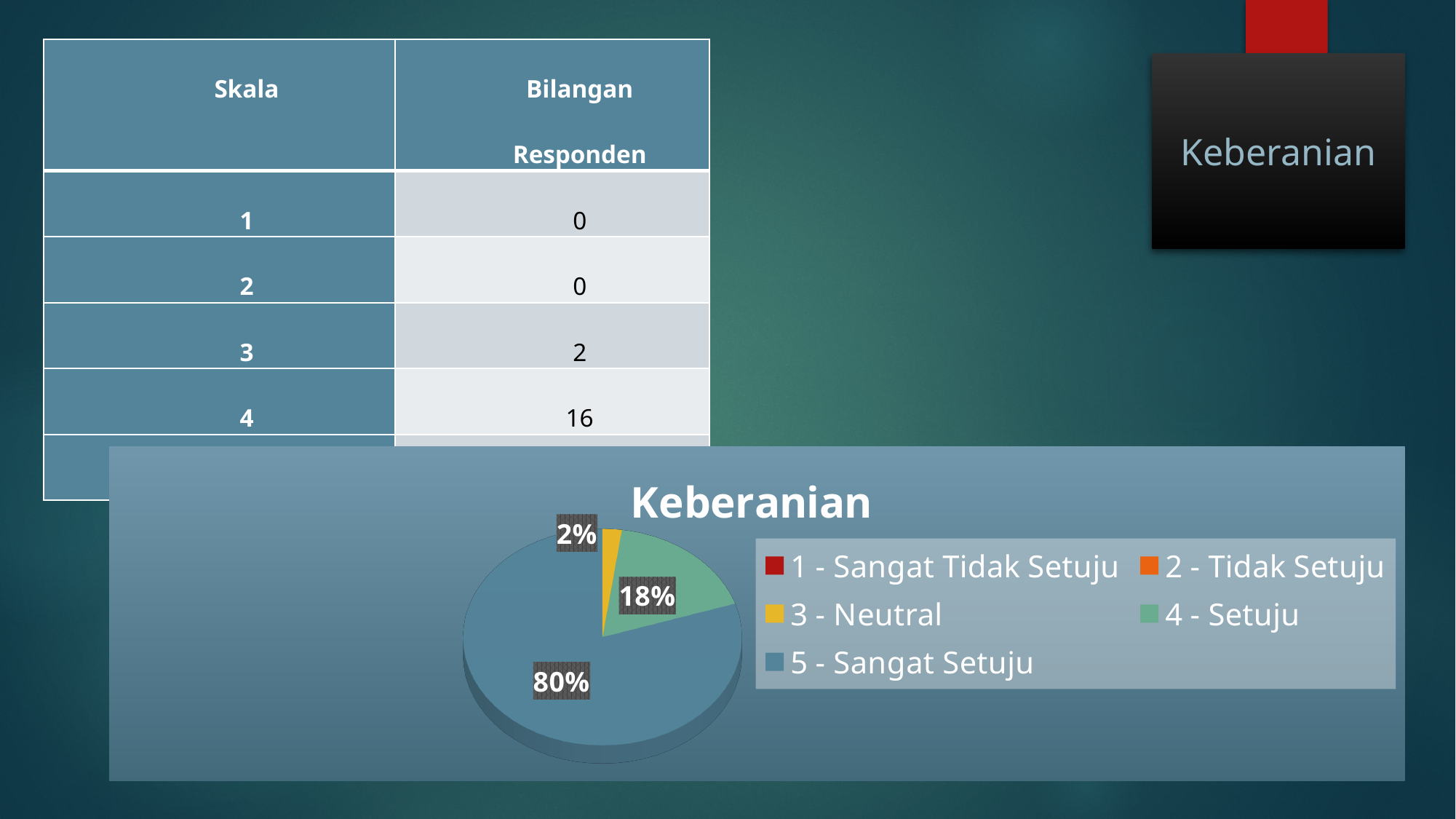
What share of the pie does the "4 - Setuju" slice represent? 18% What share of the pie does the "3 - Neutral" slice represent? 2% What share of the pie does the "5 - Sangat Setuju" slice represent? 80% What colour is the "4 - Setuju" slice in the pie chart? Green What kind of chart is shown on the slide? Pie chart Which of the visible slices is the smallest? 3 - Neutral What is the difference in percentage points between the "5 - Sangat Setuju" slice and the "4 - Setuju" slice? 62 Which category has the largest slice of the pie? 5 - Sangat Setuju What is the title of the pie chart? Keberanian Which slice is larger, "4 - Setuju" or "3 - Neutral"? 4 - Setuju How many slices with data labels are visible in the pie chart? 3 How many entries does the legend list? 5